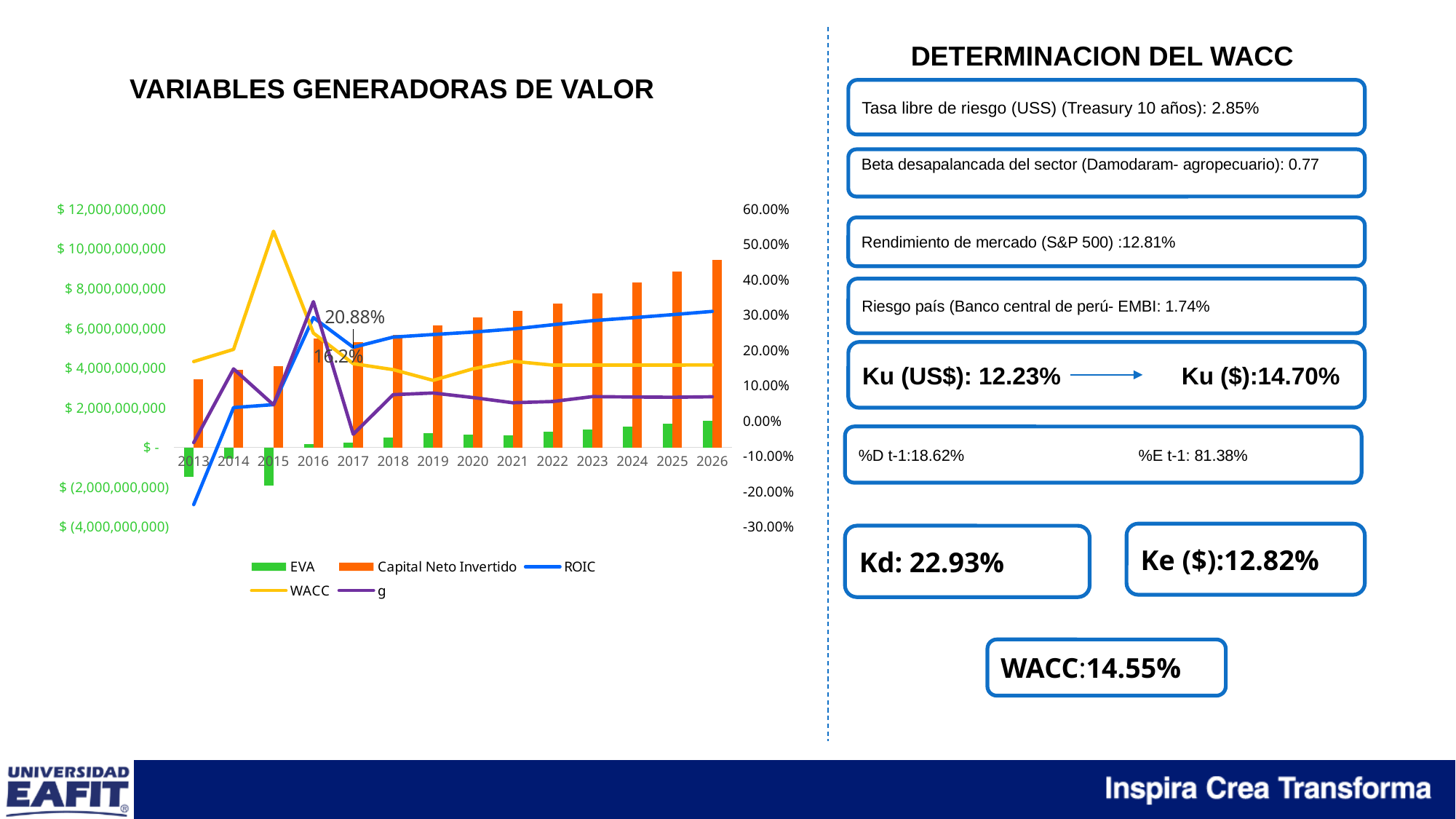
Is the Capital Neto Invertido value for 2026 greater or less than $ 8,000,000,000? greater In which year is Capital Neto Invertido highest? 2026 Does Capital Neto Invertido rise or fall from 2018 to 2026? rise Is the ROIC value for 2013 greater or less than -20.00%? less In which year is EVA lowest? 2015 How many series does the chart's legend list? 5 Which is larger, Capital Neto Invertido in 2013 or in 2026? 2026 How many years are shown on the x axis of the chart? 14 What kind of chart is shown on the slide? Combined bar and line chart What is the title of the chart on the slide? VARIABLES GENERADORAS DE VALOR In which year does the WACC line reach its highest value? 2015 Is the WACC value for 2015 greater or less than 40.00%? greater